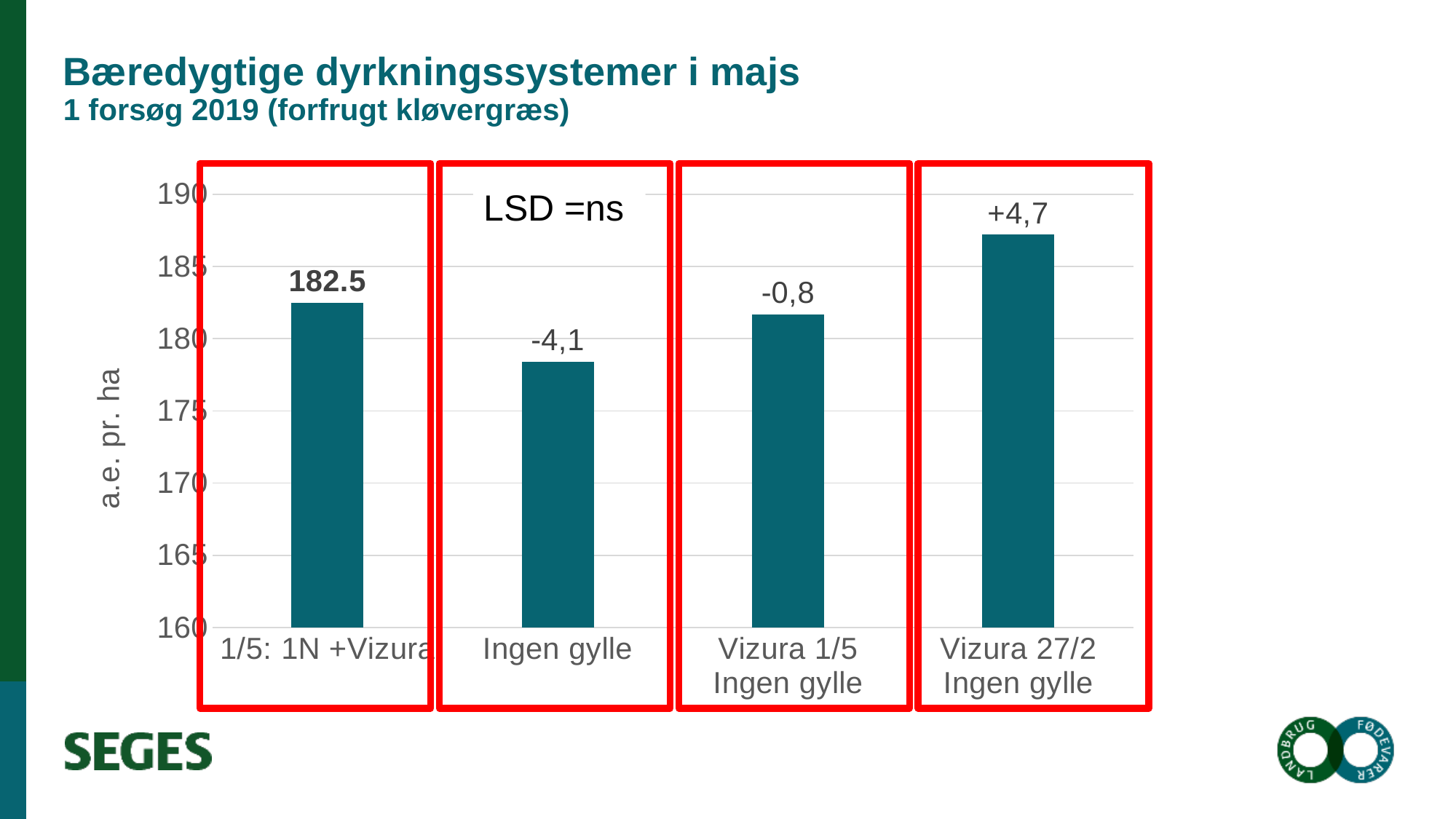
Which category has the highest bar? Vizura 27/2 Ingen gylle What label is printed above the bar for "Vizura 1/5 Ingen gylle"? -0,8 What label is printed above the bar for "Vizura 27/2 Ingen gylle"? +4,7 Is the value for "Vizura 27/2 Ingen gylle" greater or less than 185? greater What is the label on the vertical axis of the chart? a.e. pr. ha What value is printed above the bar for "1/5: 1N +Vizura"? 182.5 Which bar is taller: "1/5: 1N +Vizura" or "Ingen gylle"? 1/5: 1N +Vizura How many categories (bars) does the chart show? 4 What label is printed above the bar for "Ingen gylle"? -4,1 Is the value for "Ingen gylle" greater or less than 180? less What kind of chart is shown on the slide? bar chart Which category has the lowest bar? Ingen gylle